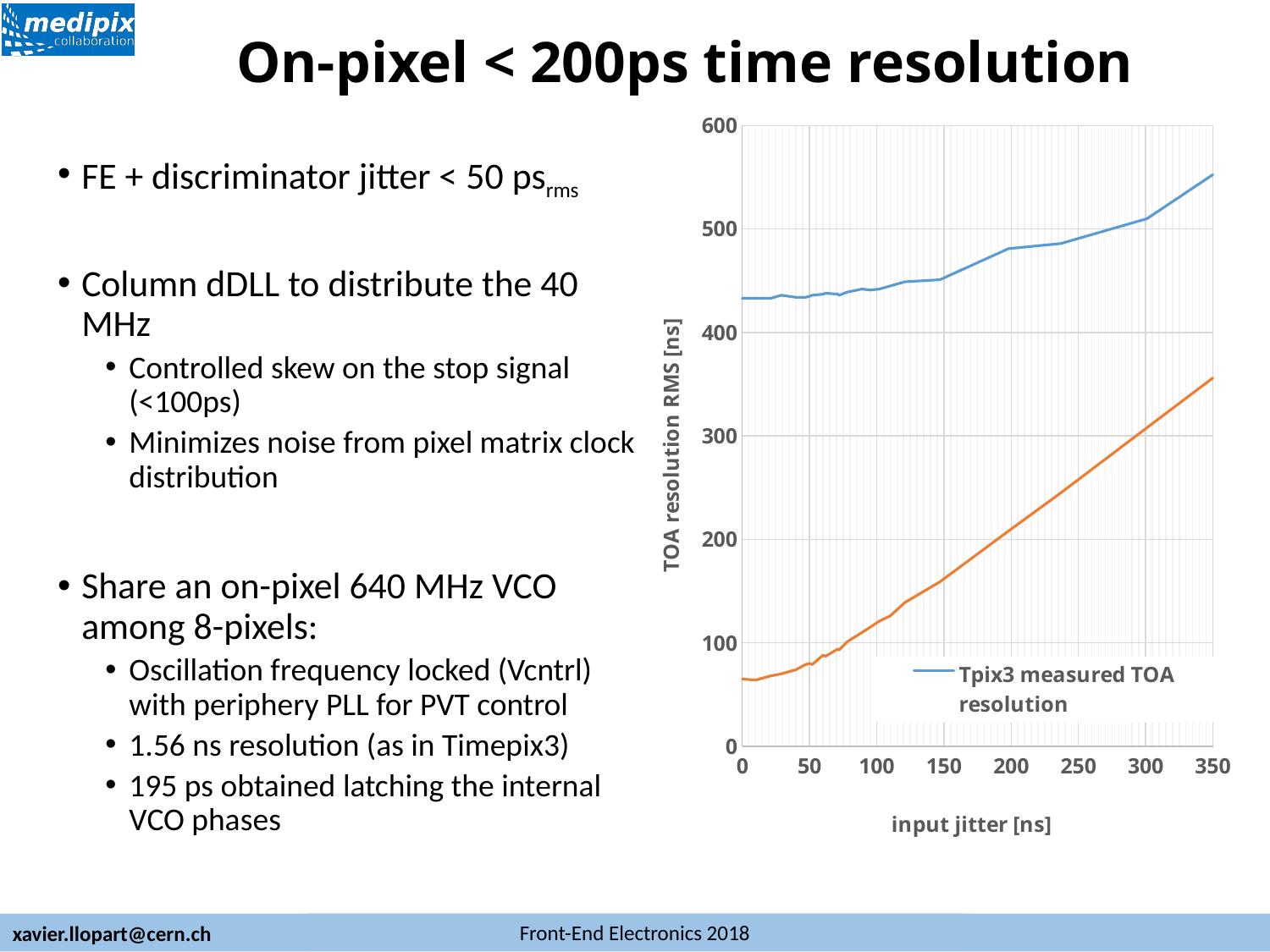
Is the orange line's value at an input jitter of 0 greater or less than 100? less Is the Tpix3 measured TOA resolution value at an input jitter of 350 greater or less than 500? greater What kind of chart is shown on the slide? line chart At an input jitter of 200, which line is higher: the Tpix3 measured TOA resolution line or the orange line? Tpix3 measured TOA resolution How many lines are plotted on the chart? 2 What is the legend entry shown on the chart? Tpix3 measured TOA resolution Is the Tpix3 measured TOA resolution value at an input jitter of 0 greater or less than 400? greater Does the Tpix3 measured TOA resolution line rise or fall as input jitter increases? rise What is the title of the x axis of the chart? input jitter [ns] Does the orange line rise or fall as input jitter increases? rise